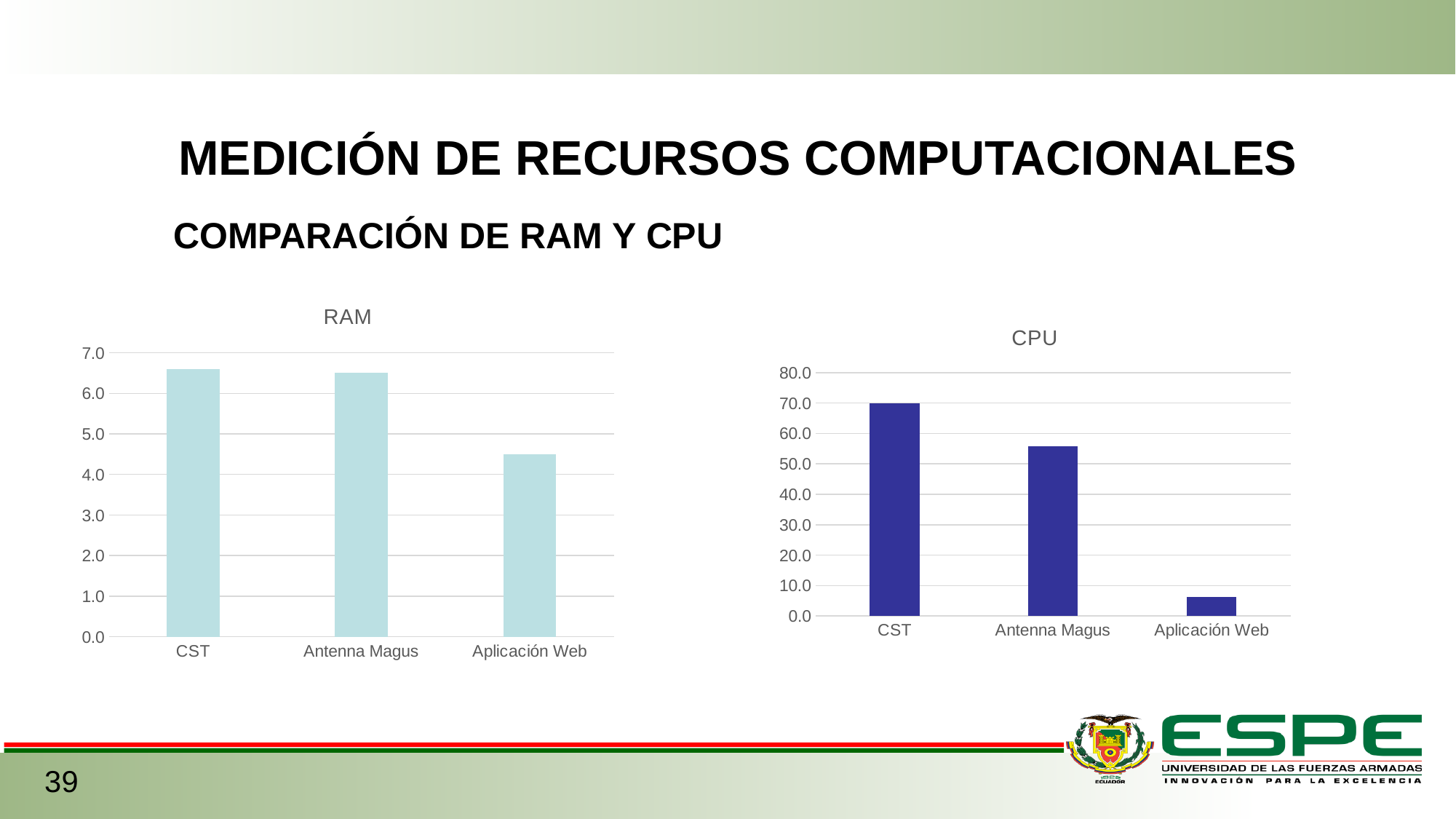
In the RAM chart, is the value for CST greater or less than 6.0? greater In the CPU chart, is the value for Aplicación Web greater or less than 10.0? less In the CPU chart, which is larger, the value for CST or the value for Antenna Magus? CST In the CPU chart, which category has the highest value? CST What kind of chart is the RAM chart? bar chart In the CPU chart, which category has the lowest value? Aplicación Web In the RAM chart, which is larger, the value for Antenna Magus or the value for Aplicación Web? Antenna Magus In the CPU chart, do the values rise or fall from left to right across the categories? fall How many categories are shown in the CPU chart? 3 In the RAM chart, which category has the lowest value? Aplicación Web In the CPU chart, is the value for Antenna Magus greater or less than 50.0? greater